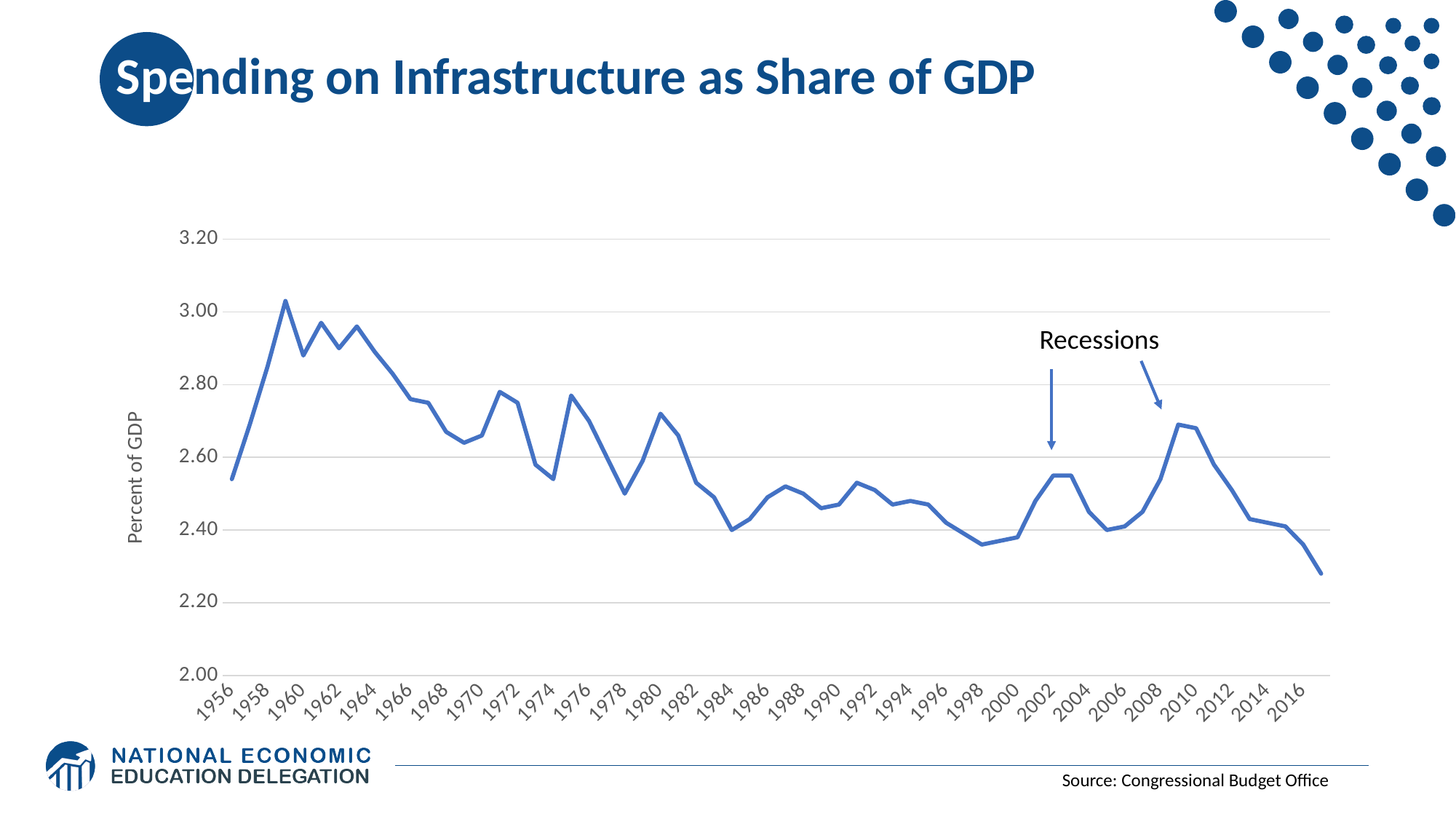
Is the value for 1998 greater or less than 2.60? less What is the title of the chart? Spending on Infrastructure as Share of GDP Is the value for 2016 greater or less than 2.60? less Is the value for 2010 greater or less than 2.60? greater Overall, does infrastructure spending as a share of GDP rise or fall from 1956 to the end of the series? fall Which year has the larger value, 1960 or 2010? 1960 Which year has the larger value, 1956 or 2016? 1956 What kind of chart is shown on the slide? line chart What is the label on the vertical axis of the chart? Percent of GDP